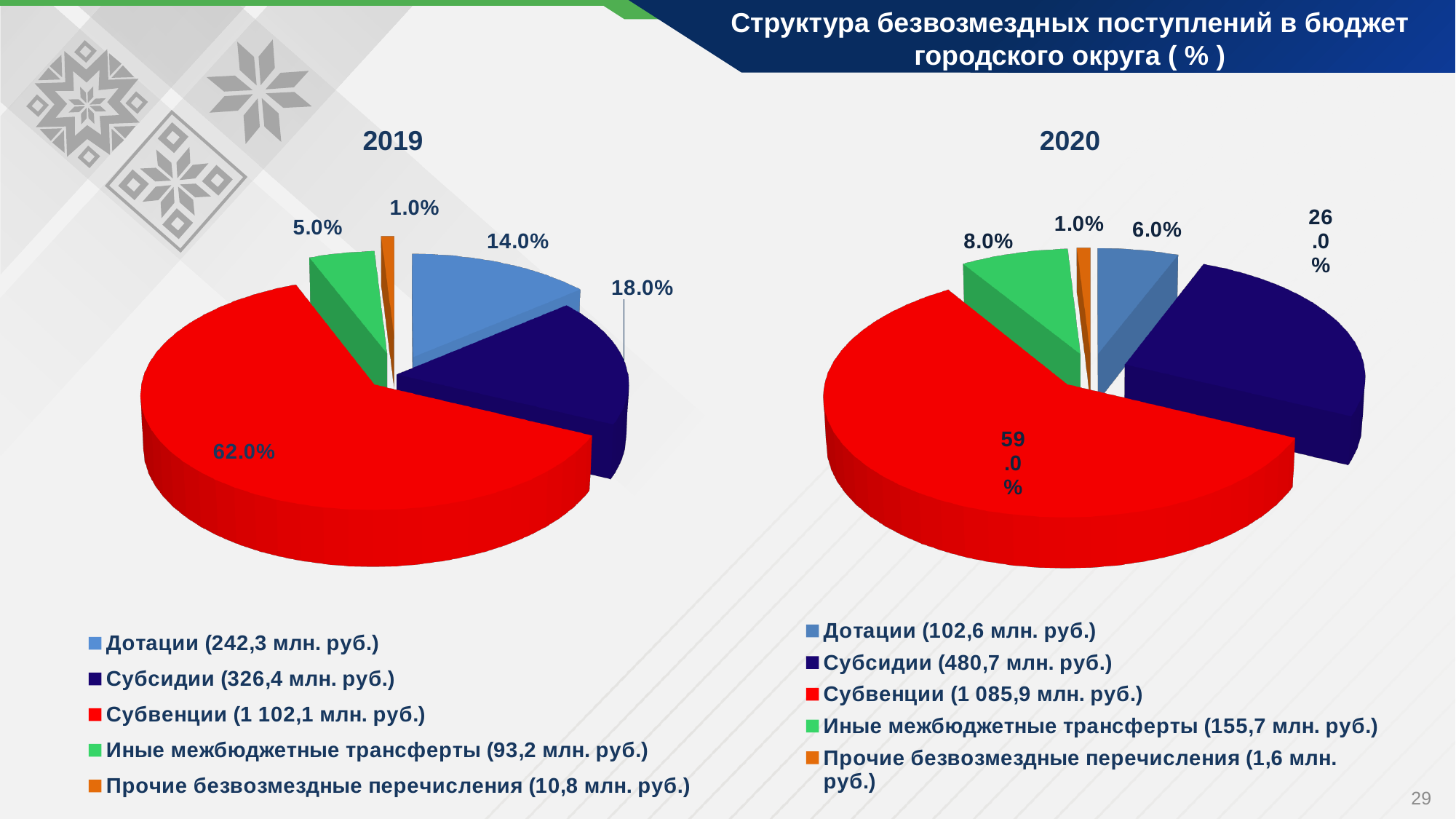
In the 2019 pie chart, what is the difference between the shares of Субсидии and Дотации? 4.0% In the 2020 pie chart, what share is shown for Субсидии? 26.0% In the 2020 pie chart, which is larger: the share of Иные межбюджетные трансферты or the share of Дотации? Иные межбюджетные трансферты How many slices does the 2019 pie chart have? 5 In the 2020 pie chart, what share is shown for Дотации? 6.0% In the 2019 chart legend, what amount in млн. руб. is given for Субвенции? 1 102,1 млн. руб. In the 2019 pie chart, what share is shown for Иные межбюджетные трансферты? 5.0% What type of chart is used for the 2020 data? Pie chart In the 2020 pie chart, which category has the smallest share? Прочие безвозмездные перечисления In the 2020 chart legend, what amount in млн. руб. is given for Иные межбюджетные трансферты? 155,7 млн. руб. In the 2019 pie chart, which category has the largest share? Субвенции In the 2019 pie chart, what share is shown for Субвенции? 62.0%